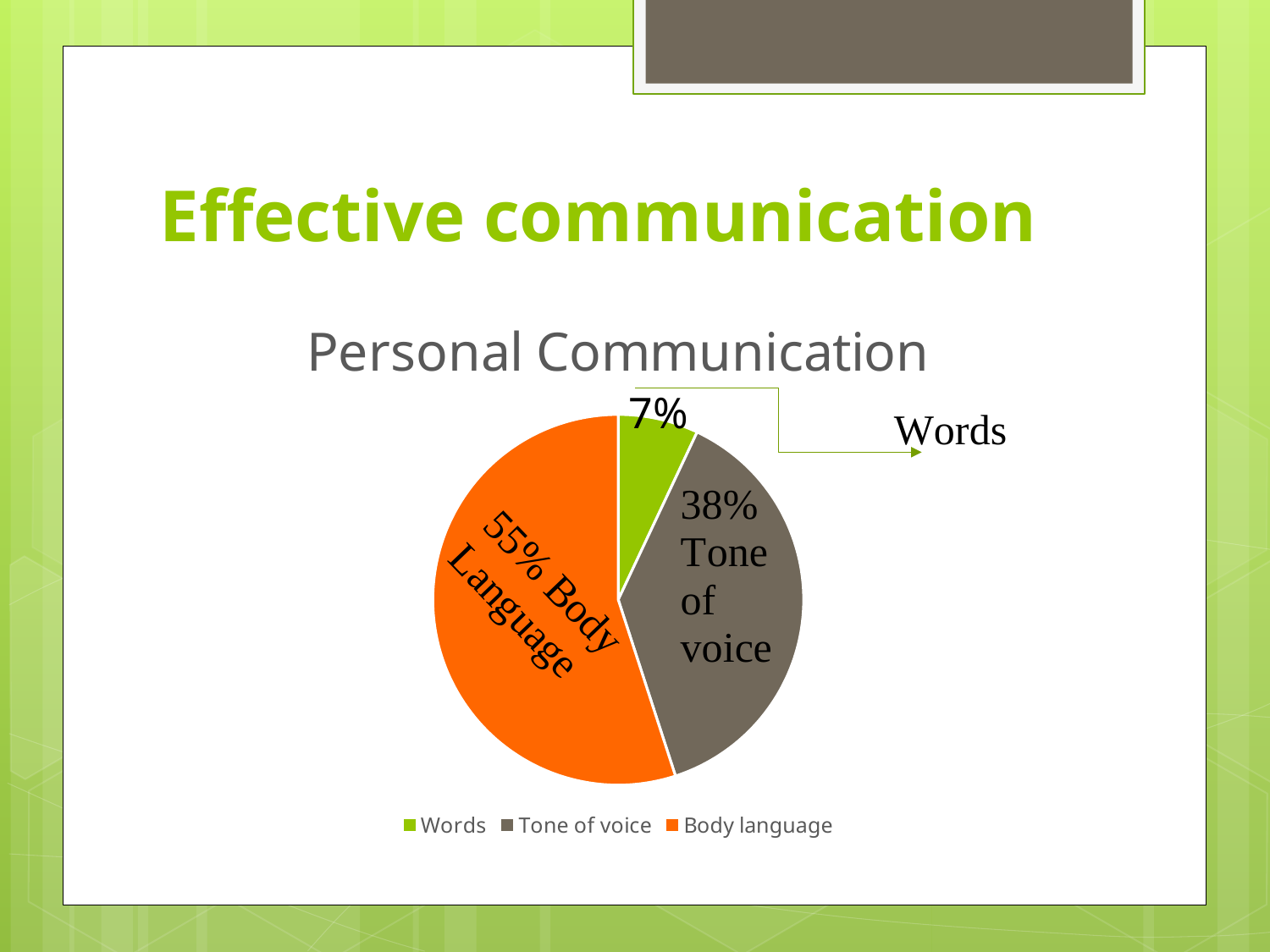
What is the difference in percentage points between Body language and Tone of voice? 17 What colour is the Body language slice? orange What percentage does the Words slice represent? 7% Which category has the largest share of the pie? Body language What percentage does the Body language slice represent? 55% What is the title of the chart? Personal Communication Which is larger, the share for Tone of voice or the share for Words? Tone of voice What percentage does the Tone of voice slice represent? 38% How many slices does the pie chart have? 3 What is the difference in percentage points between Tone of voice and Words? 31 Which category has the smallest share of the pie? Words What kind of chart is shown on the slide? pie chart